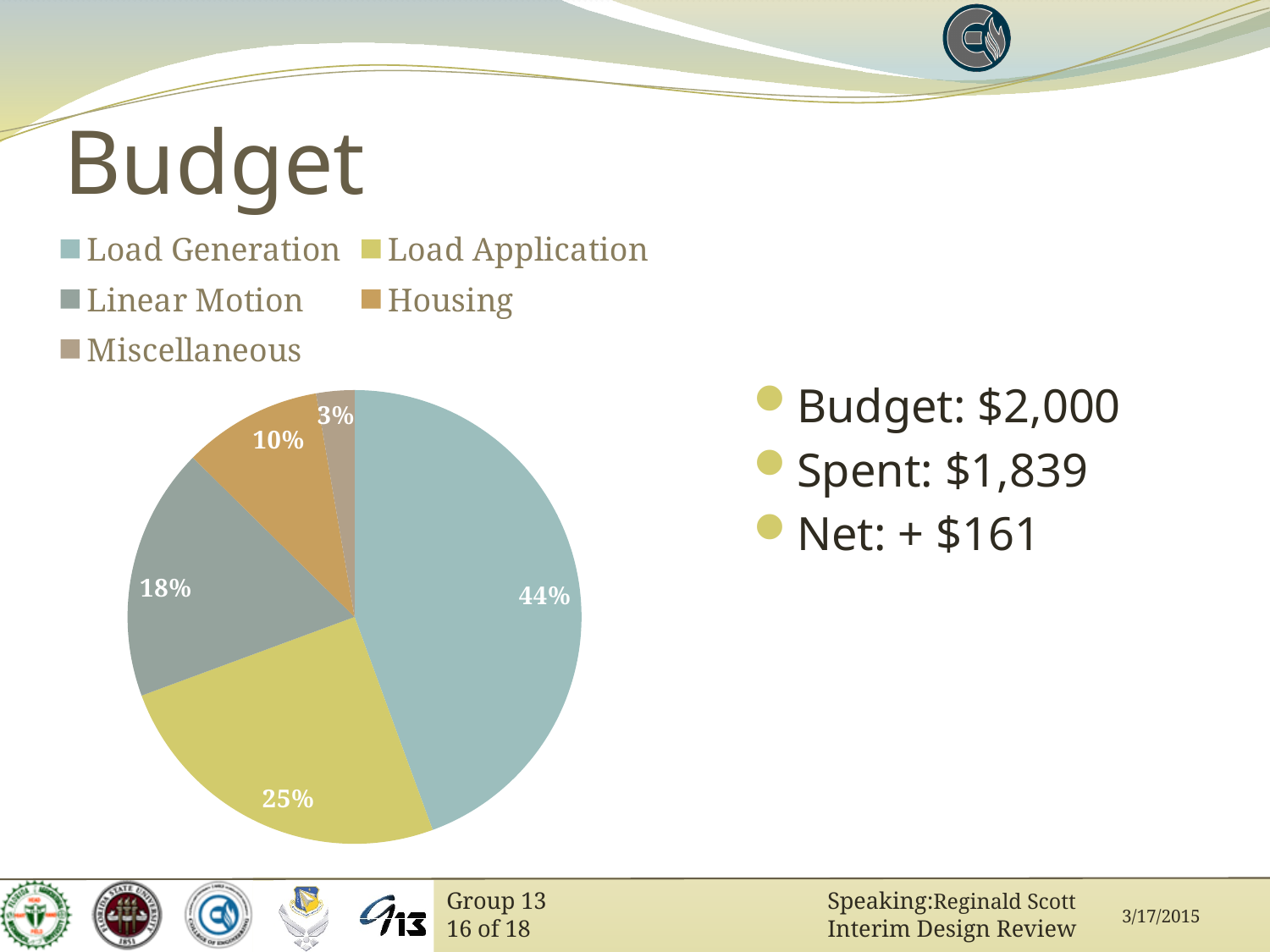
What share of the pie does Load Application account for? 25% Which category has the smallest slice of the pie? Miscellaneous What share of the pie does Housing account for? 10% Which category has the largest slice of the pie? Load Generation What share of the pie does Load Generation account for? 44% Which category is listed first in the chart legend? Load Generation What kind of chart is shown on the slide? pie chart Which is larger, the share for Linear Motion or the share for Housing? Linear Motion What is the difference in percentage points between Load Generation and Load Application? 19 How many categories are shown in the pie chart? 5